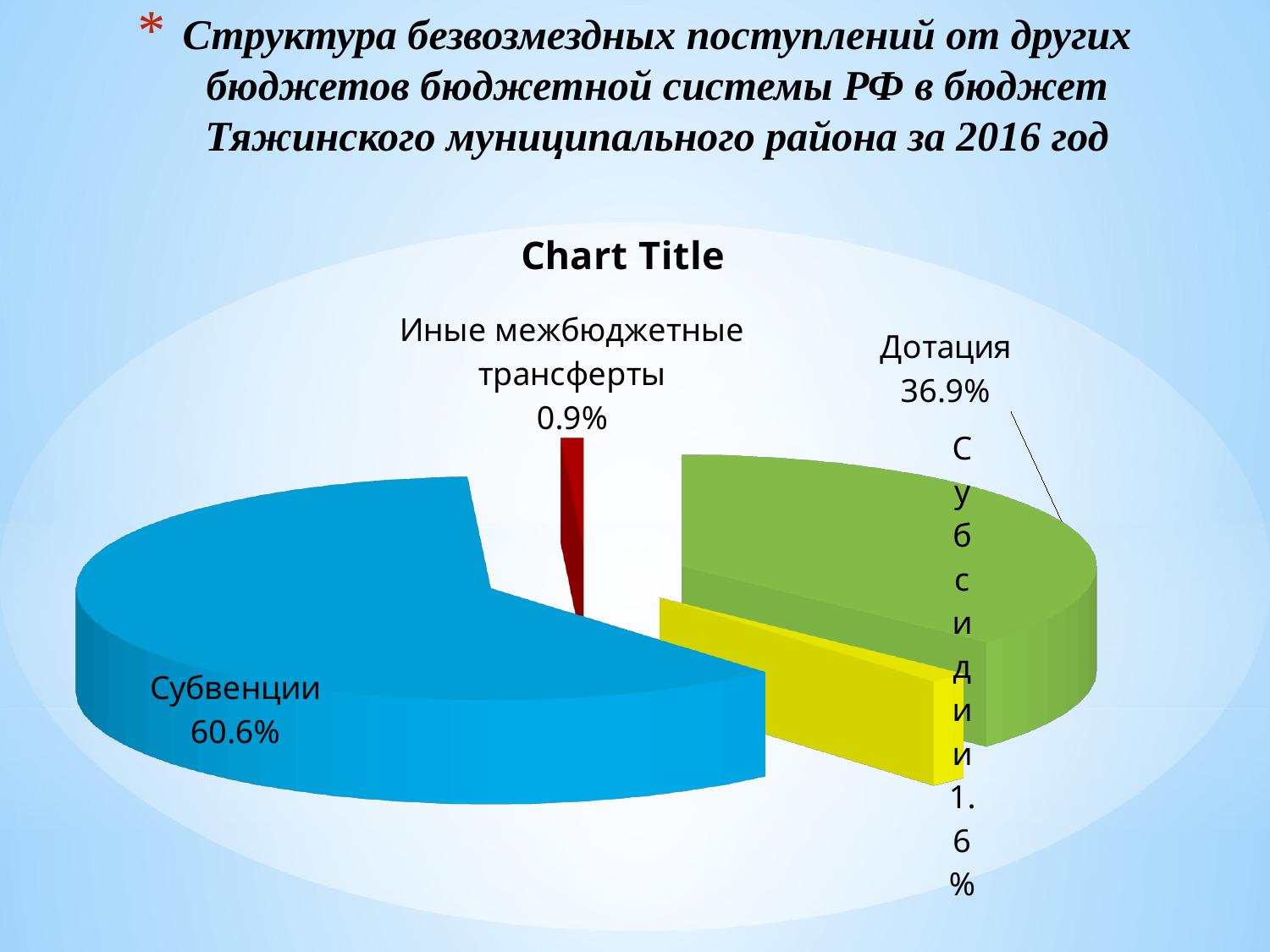
What kind of chart is shown on the slide? Pie chart What share of the pie does Субсидии have? 1.6% How many slices does the pie chart have? 4 Which category has the largest share of the pie? Субвенции What colour is the Субвенции slice? Blue Which category has the smallest share of the pie? Иные межбюджетные трансферты What share of the pie does Дотация have? 36.9% What is the title shown above the pie chart? Chart Title What share of the pie does Иные межбюджетные трансферты have? 0.9% What share of the pie does Субвенции have? 60.6% Which is larger, the share for Субсидии or the share for Иные межбюджетные трансферты? Субсидии What is the difference in percentage points between Субвенции and Дотация? 23.7